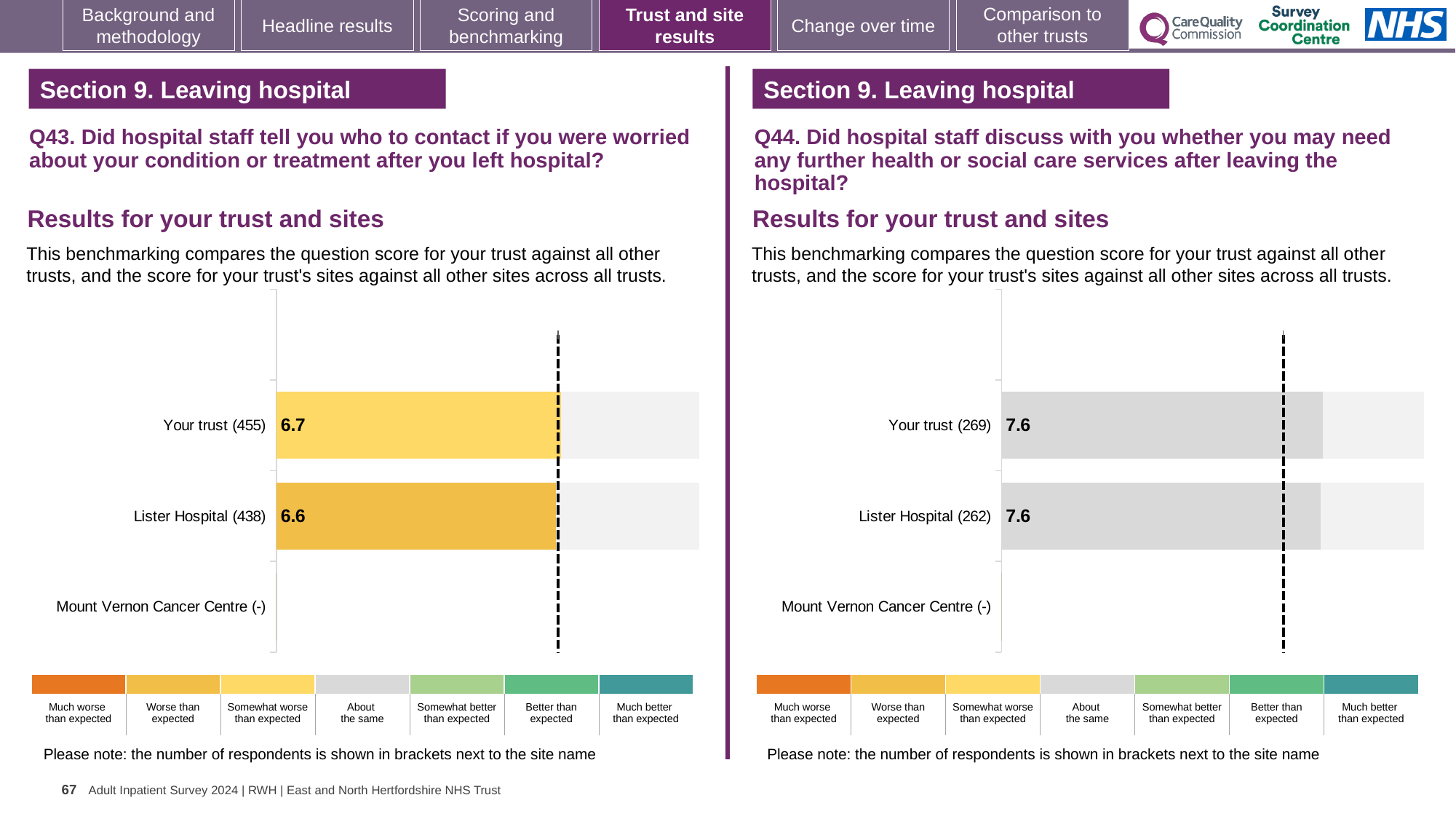
What kind of chart is used on the Q44 chart (right)? Bar chart On the Q43 chart (left), which benchmark category does the colour of the Lister Hospital bar correspond to in the legend? Worse than expected On the Q43 chart (left), what is the score for Lister Hospital? 6.6 On the Q43 chart (left), what is the difference between the scores for Your trust and Lister Hospital? 0.1 On the Q44 chart (right), what is the difference between the scores for Your trust and Lister Hospital? 0 On the Q44 chart (right), how many respondents are shown for Lister Hospital? 262 On the Q43 chart (left), how many respondents are shown for Your trust? 455 On the Q43 chart (left), what is the score for Your trust? 6.7 On the Q44 chart (right), what is the score for Lister Hospital? 7.6 On the Q43 chart (left), how many site/trust categories are listed on the vertical axis? 3 On the Q44 chart (right), what is the score for Your trust? 7.6 On the Q44 chart (right), which benchmark category does the colour of the Your trust bar correspond to in the legend? About the same